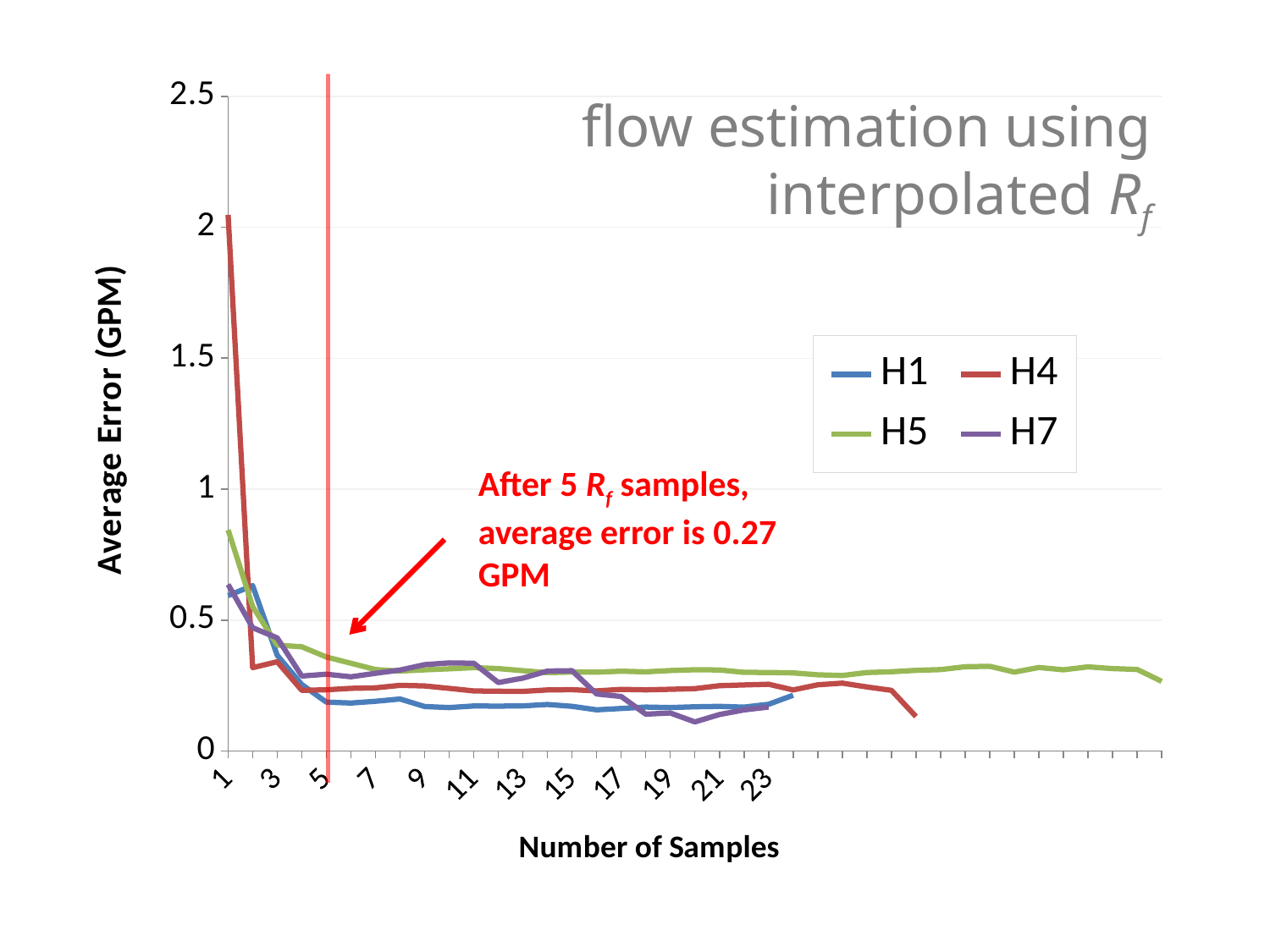
Which series reaches the lowest average error on the chart? H7 Which series extends furthest along the x axis? H5 How many series does the legend list? 4 According to the annotation, what is the average error after 5 Rf samples? 0.27 GPM At 1 sample, which series has the larger average error, H4 or H5? H4 Is the average error for H1 at 23 samples greater or less than 0.5? less Which series has the highest average error at 1 sample? H4 Is the average error for H4 at 1 sample greater or less than 1.5? greater What kind of chart is shown on the slide? line chart Is the average error for H5 at 1 sample greater or less than 1? less Do the average error values generally rise or fall as the number of samples increases? fall